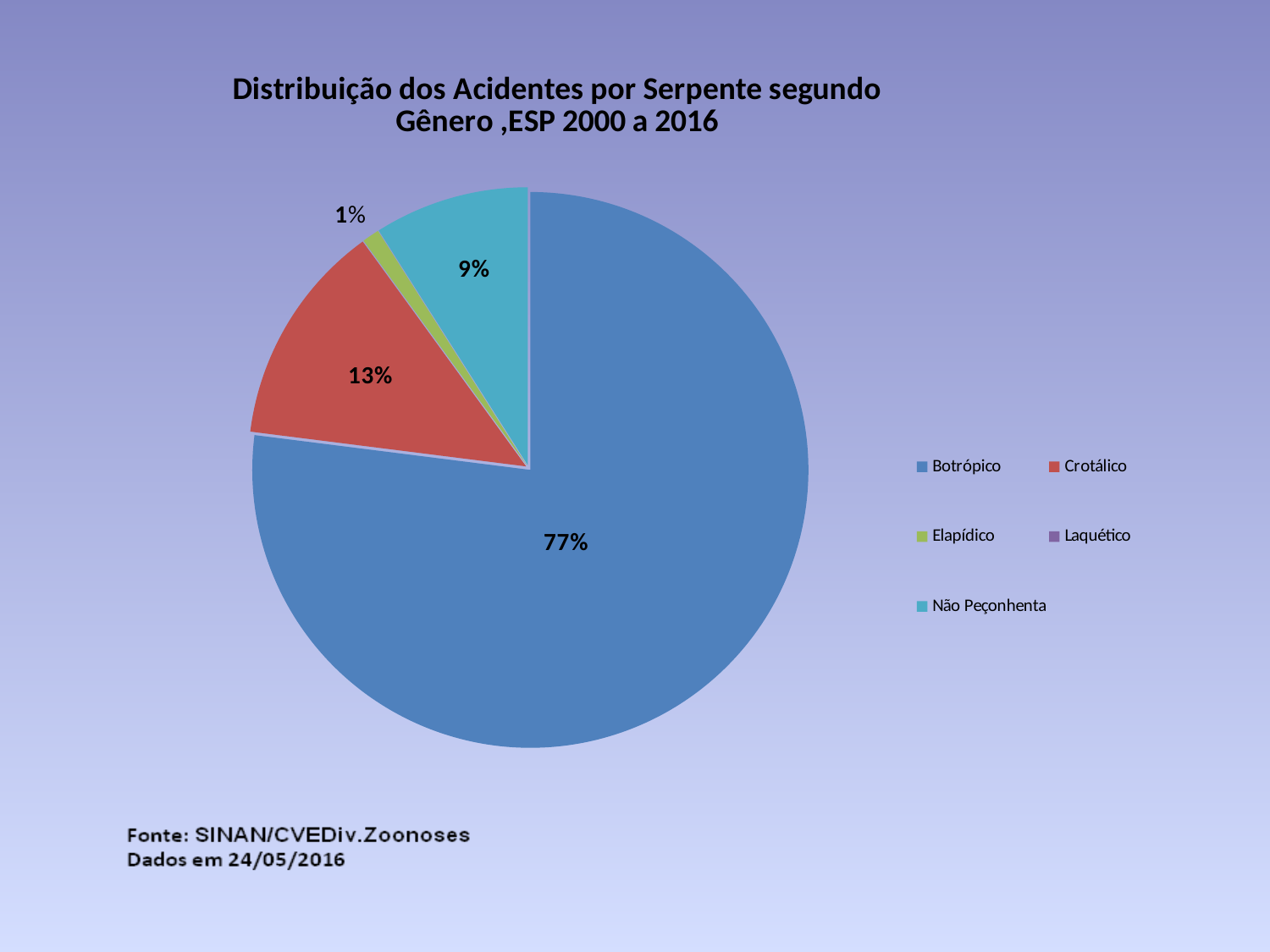
How many entries does the legend list? 5 What share of accidents is attributed to Botrópico? 77% Which category has the largest slice of the pie? Botrópico What colour is the Crotálico slice? red What type of chart is shown on the slide? pie chart What share of accidents is attributed to Crotálico? 13% What share of accidents is attributed to Não Peçonhenta? 9% Which of the labelled slices is the smallest? Elapídico Which slice is larger, Crotálico or Não Peçonhenta? Crotálico What is the title of the chart? Distribuição dos Acidentes por Serpente segundo Gênero ,ESP 2000 a 2016 What is the difference in percentage points between the Botrópico and Crotálico slices? 64